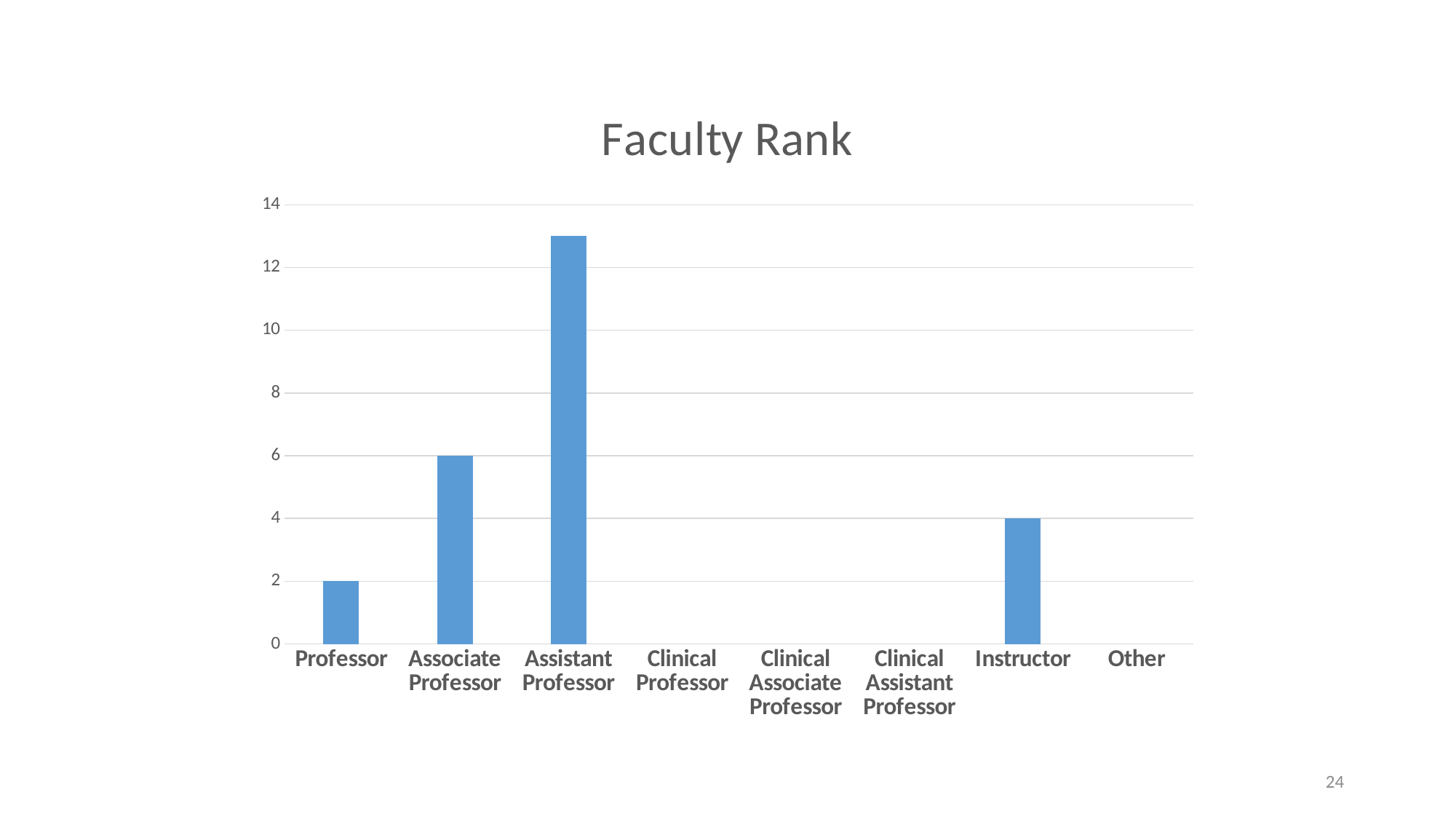
Which faculty rank has the highest value? Assistant Professor What is the title of the chart? Faculty Rank What is the difference between the values for Associate Professor and Professor? 4 Which is larger, the value for Associate Professor or the value for Instructor? Associate Professor What type of chart is shown on the slide? bar chart Is the value for Assistant Professor greater or less than 12? greater What is the value for Instructor? 4 How many faculty rank categories are shown on the x axis? 8 What is the difference between the values for Associate Professor and Instructor? 2 What is the value for Professor? 2 Is the value for Associate Professor greater or less than 8? less What is the value for Associate Professor? 6